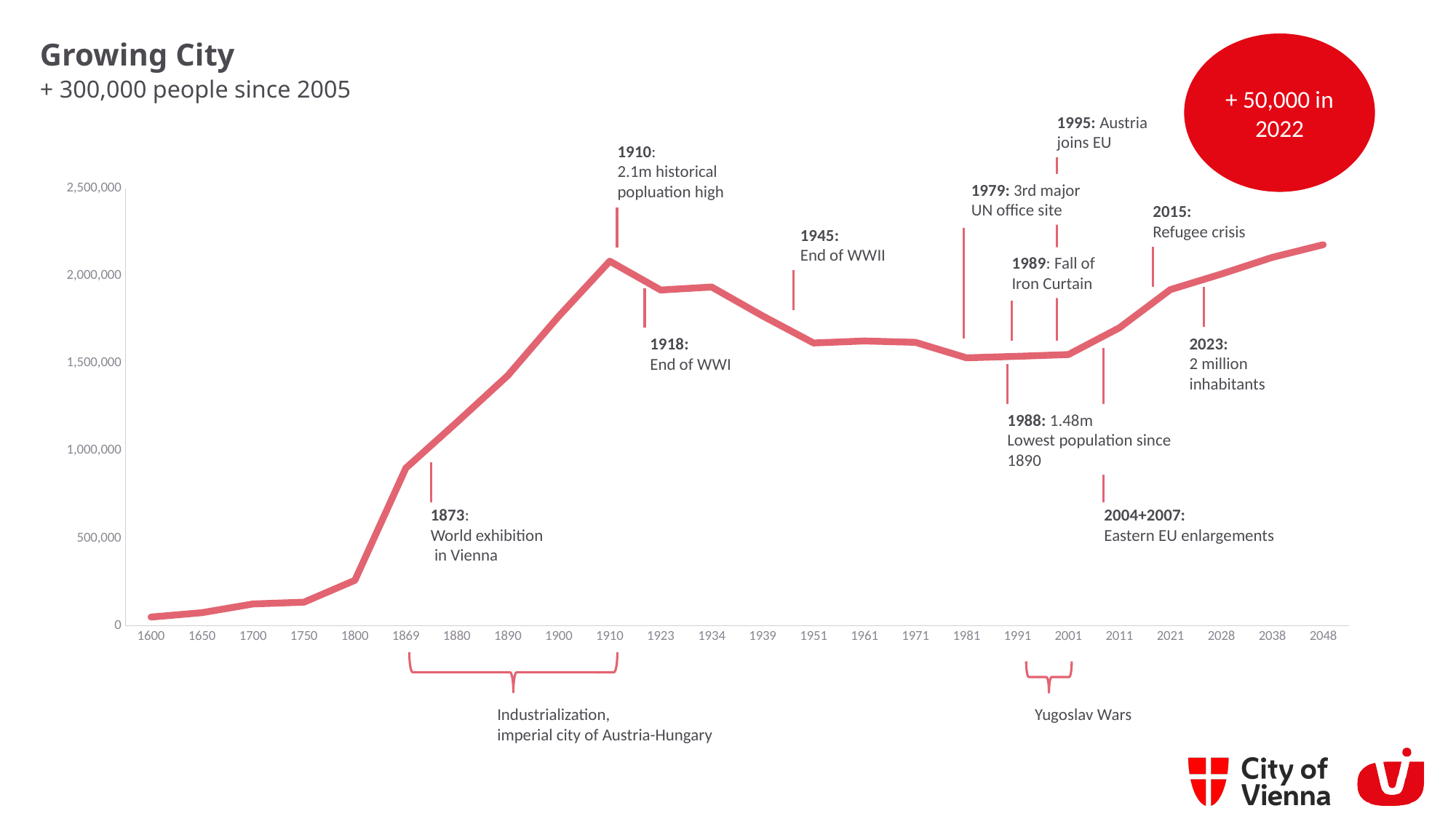
Is the value for 1869 greater or less than 1,000,000? less Is the value for 1951 greater or less than 1,500,000? greater In which year does the population line reach its highest point? 2048 Is the value for 1800 greater or less than 500,000? less How many years are labelled along the x axis of the chart? 24 Which year has the larger population value, 1800 or 1869? 1869 Does the population line rise or fall between 1910 and 1981? fall According to the annotation, what was the historical population high in 1910? 2.1m In which year is the population line at its lowest point? 1600 What kind of chart is shown on the slide? line chart What is the title of the slide containing the chart? Growing City